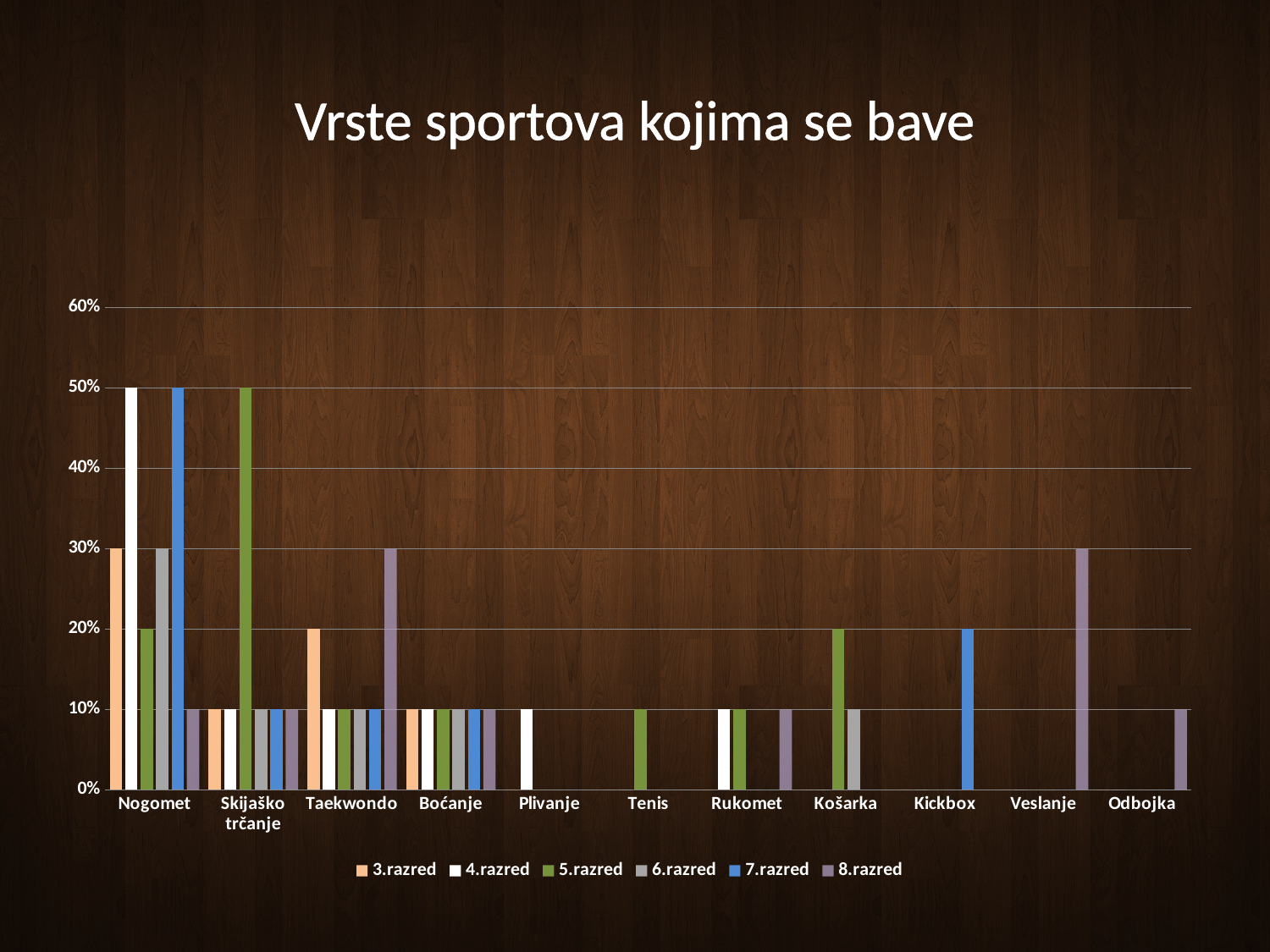
What kind of chart is shown on the slide? bar chart What is the difference between the 3.razred value for Nogomet and the 3.razred value for Taekwondo? 10% What is the value for 8.razred in the Veslanje category? 30% What is the title of the chart? Vrste sportova kojima se bave What is the value for 4.razred in the Nogomet category? 50% What is the value for 7.razred in the Kickbox category? 20% Is the value for 7.razred in the Nogomet category greater or less than 40%? greater What is the value for 5.razred in the Skijaško trčanje category? 50% Which series has the highest value in the Taekwondo category? 8.razred Which is larger: the 5.razred value for Košarka or the 6.razred value for Košarka? 5.razred How many sport categories are shown on the x axis? 11 How many series does the legend list? 6